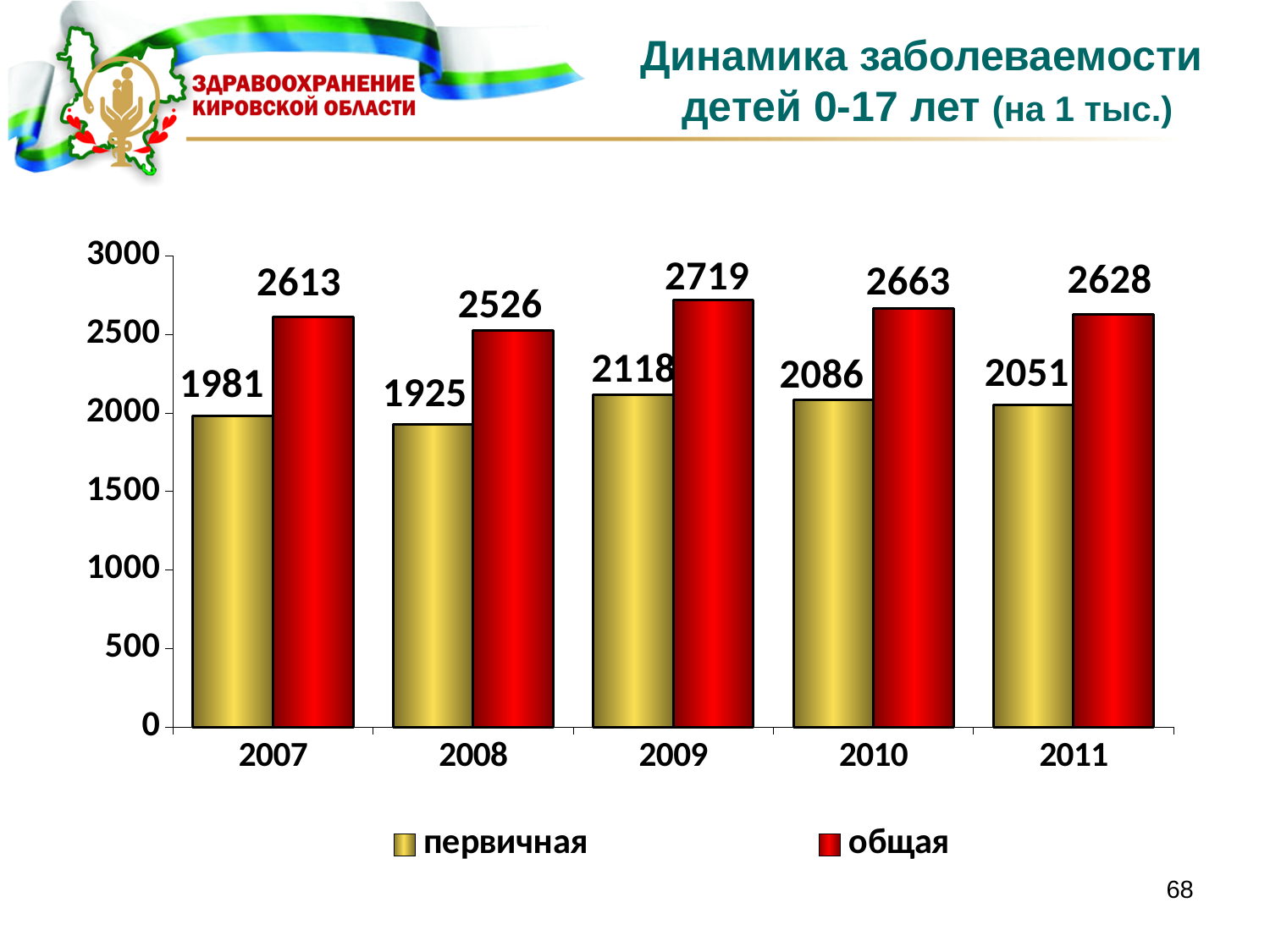
What kind of chart is shown on the slide? bar chart Is the value of первичная for 2010 greater or less than 2000? greater What is the value of первичная for 2008? 1925 In which year is первичная lowest? 2008 How many years are shown on the x axis? 5 What is the difference between общая and первичная in 2007? 632 What is the value of первичная for 2009? 2118 Which colour represents the series общая? red How many series does the legend list? 2 Which is larger: общая in 2010 or общая in 2011? общая in 2010 In which year is общая highest? 2009 What is the value of общая for 2011? 2628